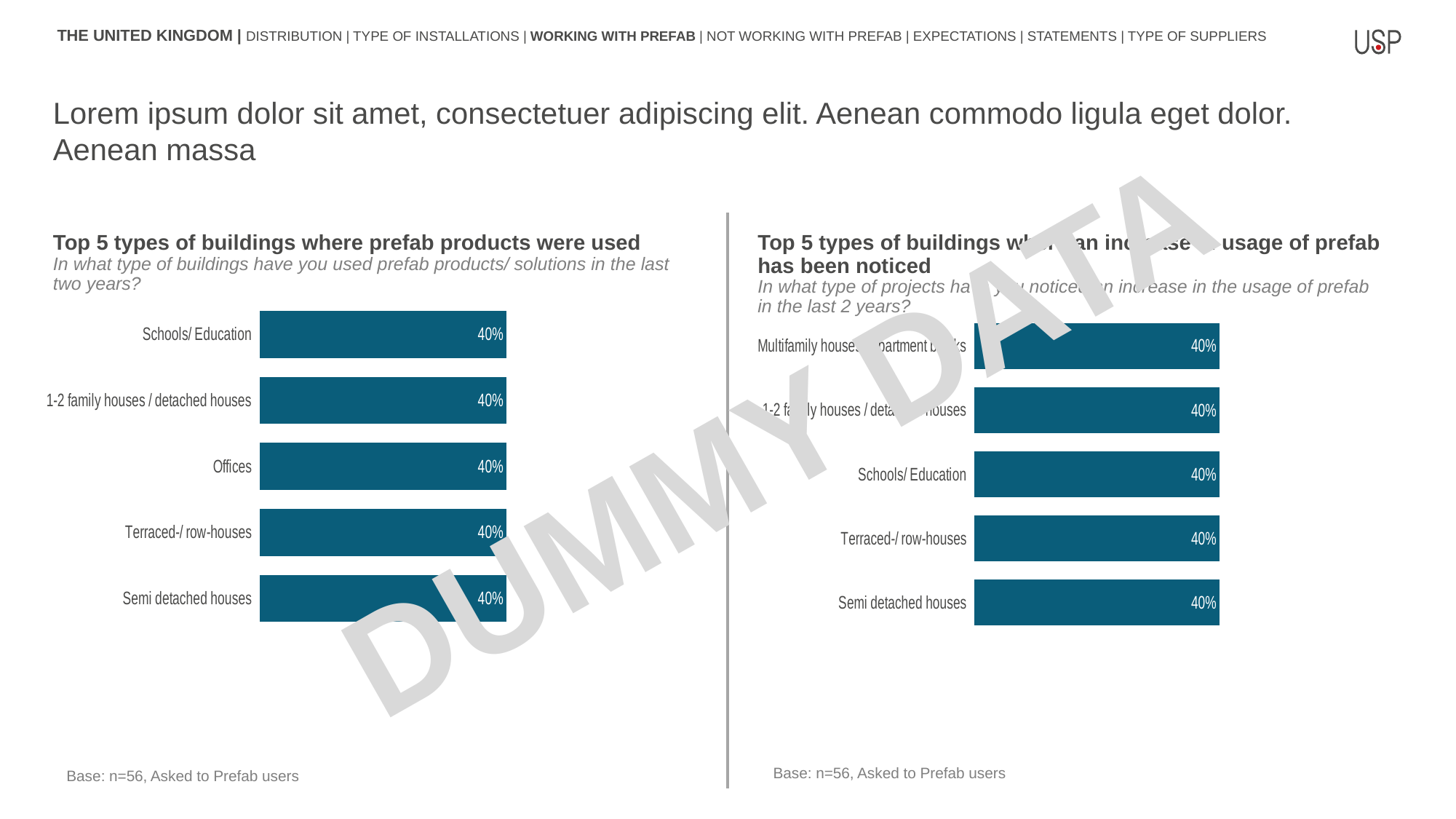
On the left chart, what is the value for Schools/ Education? 40% What kind of chart is the left chart? Bar chart What is the title of the left chart? Top 5 types of buildings where prefab products were used On the right chart, what is the value for Schools/ Education? 40% On the left chart, what is the difference between the values for Offices and Semi detached houses? 0% On the left chart, what is the value for Offices? 40% What is the base (sample size) stated below the left chart? n=56, Asked to Prefab users On the right chart, what is the value for Semi detached houses? 40% On the left chart, what is the value for Terraced-/ row-houses? 40% How many categories are shown on the right chart? 5 On the left chart, what is the value for Semi detached houses? 40% How many categories are shown on the left chart? 5